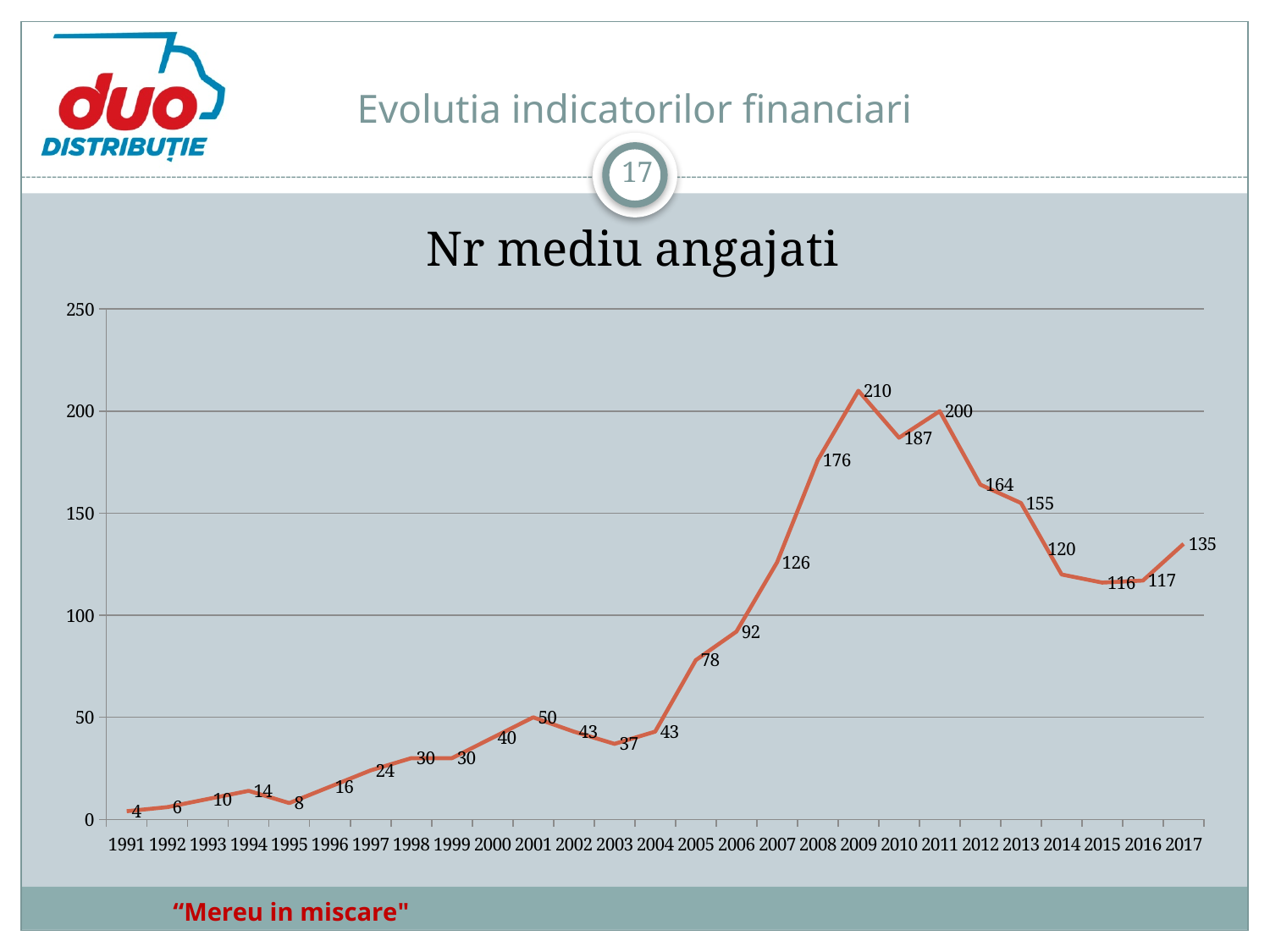
What is the title of the chart on the slide? Nr mediu angajati What is the value for 2017 in the Nr mediu angajati chart? 135 Is the value for 2007 greater or less than 150 in the Nr mediu angajati chart? less Do the values in the Nr mediu angajati chart rise or fall from 2009 to 2015? fall What kind of chart is the Nr mediu angajati chart? line chart What is the difference between the values for 2011 and 2012 in the Nr mediu angajati chart? 36 Which year has the lowest value in the Nr mediu angajati chart? 1991 Which is larger in the Nr mediu angajati chart, the value for 2008 or the value for 2013? 2008 Which year has the highest value in the Nr mediu angajati chart? 2009 What is the value for 1991 in the Nr mediu angajati chart? 4 How many years are plotted on the x axis of the Nr mediu angajati chart? 27 What is the value for 2009 in the Nr mediu angajati chart? 210